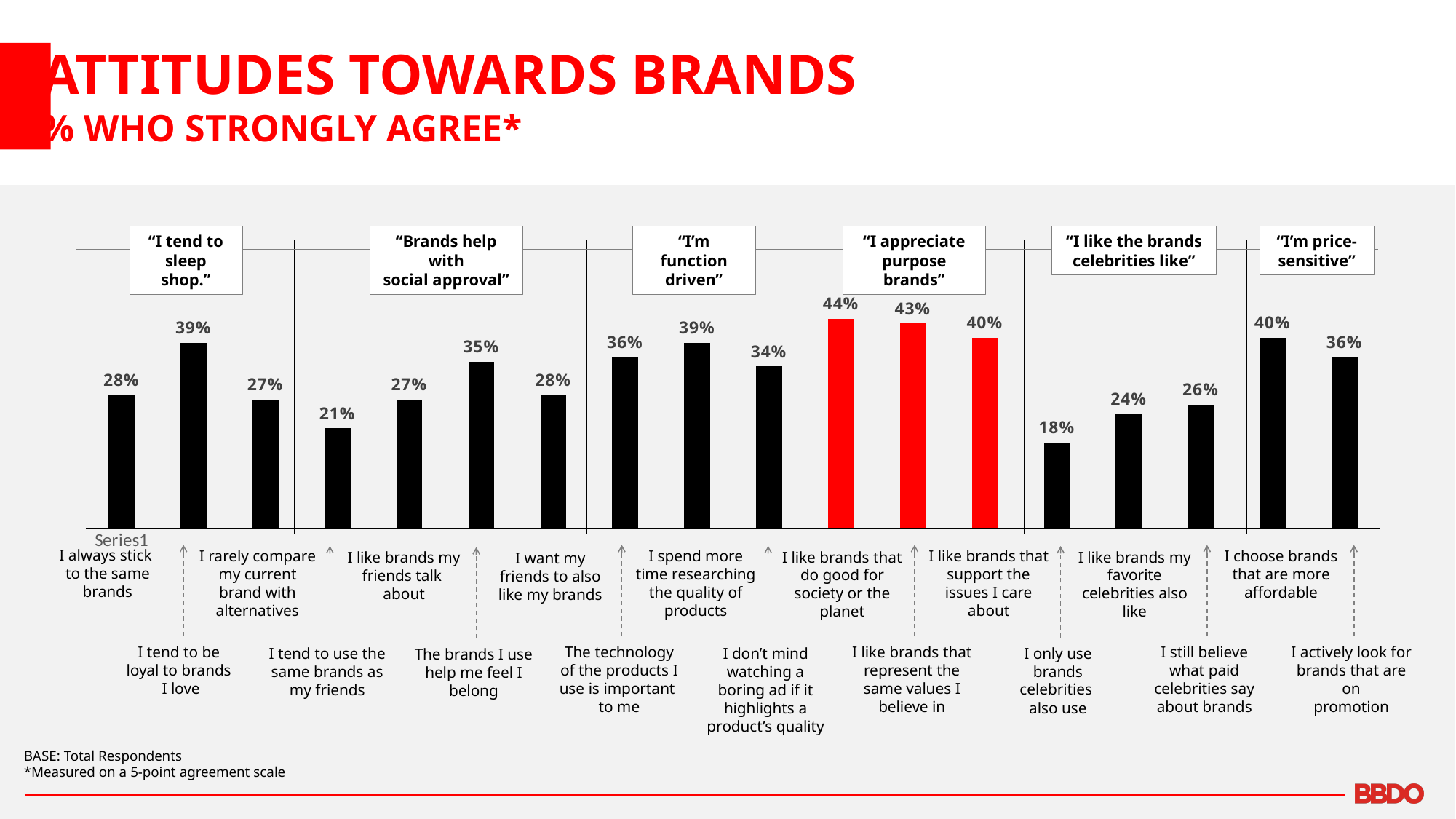
How many bars are plotted in the chart? 18 What type of chart is shown on the slide? Bar chart Which is larger: "The brands I use help me feel I belong" or "I want my friends to also like my brands"? The brands I use help me feel I belong How many attitude groups are labelled above the bars? 6 Which statement has the highest percentage of strong agreement? I like brands that do good for society or the planet What is the difference between "I tend to be loyal to brands I love" and "I always stick to the same brands"? 11% Which group of bars is highlighted in red? "I appreciate purpose brands" What percentage strongly agree with "I only use brands celebrities also use"? 18% What percentage strongly agree with "I choose brands that are more affordable"? 40% What percentage strongly agree with "I tend to use the same brands as my friends"? 21% Which statement has the lowest percentage of strong agreement? I only use brands celebrities also use What percentage strongly agree with "I like brands that do good for society or the planet"? 44%